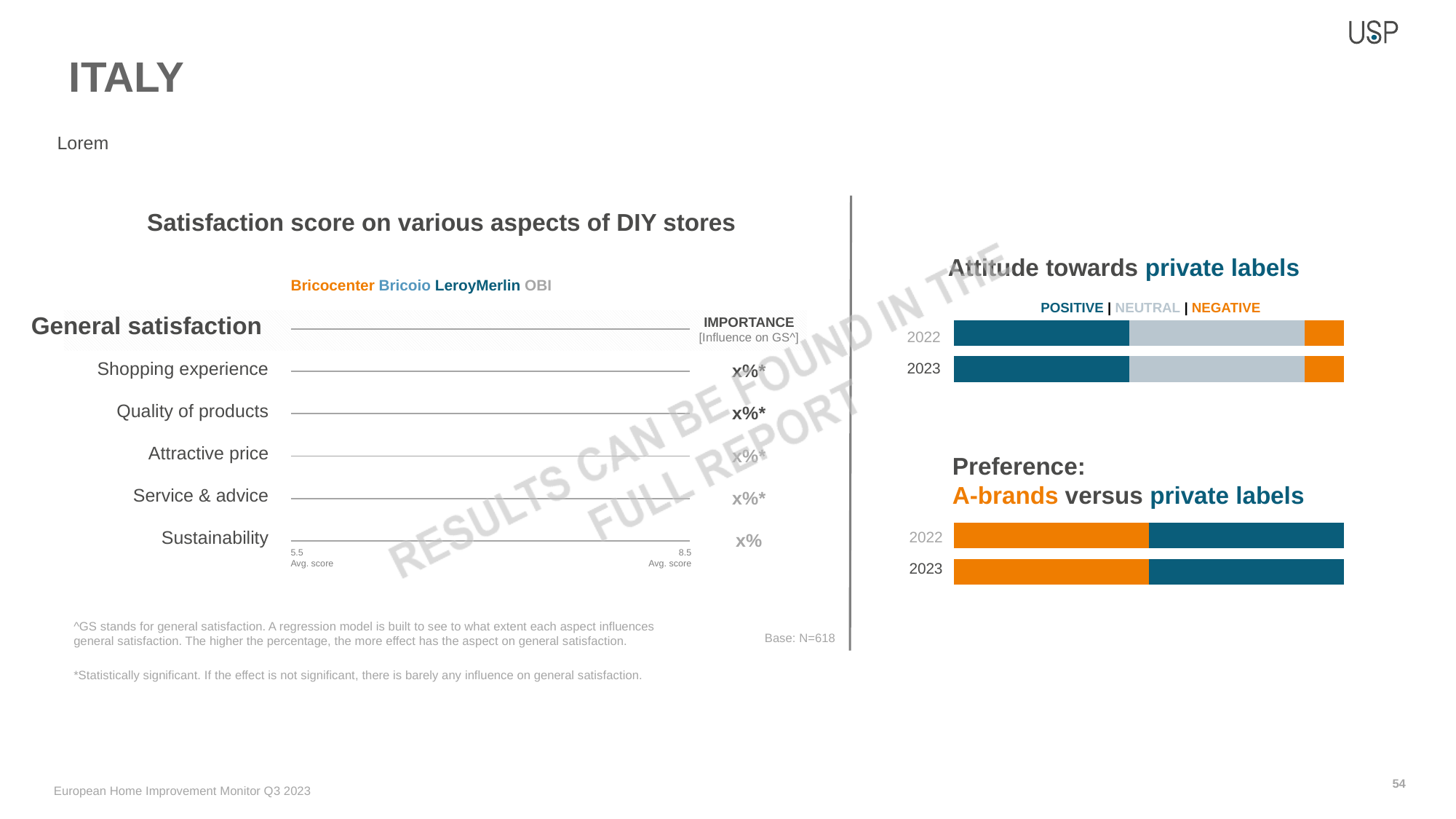
In the 'Satisfaction score on various aspects of DIY stores' chart, what are the minimum and maximum values shown on the average score axis? 5.5 and 8.5 In the 'Attitude towards private labels' chart, which segment is the smallest in the 2023 bar? Negative In the 'Satisfaction score on various aspects of DIY stores' chart, which stores are listed in the legend? Bricocenter, Bricoio, LeroyMerlin, OBI In the 'Satisfaction score on various aspects of DIY stores' chart, how many aspects (rows) are listed, including General satisfaction? 6 In the 'Preference: A-brands versus private labels' chart, how many series are shown? 2 In the 'Satisfaction score on various aspects of DIY stores' chart, how many stores does the legend list? 4 What is the base (sample size) stated for the Italy charts? N=618 In the 'Preference: A-brands versus private labels' chart, how many bars are plotted? 2 In the 'Attitude towards private labels' chart, how many series does the legend list? 3 In the 'Attitude towards private labels' chart, which years are shown as bars? 2022 and 2023 In the 'Attitude towards private labels' chart, what kind of chart is used? Stacked bar chart In the 'Attitude towards private labels' chart, for 2022, is the Positive segment larger or smaller than the Negative segment? Larger